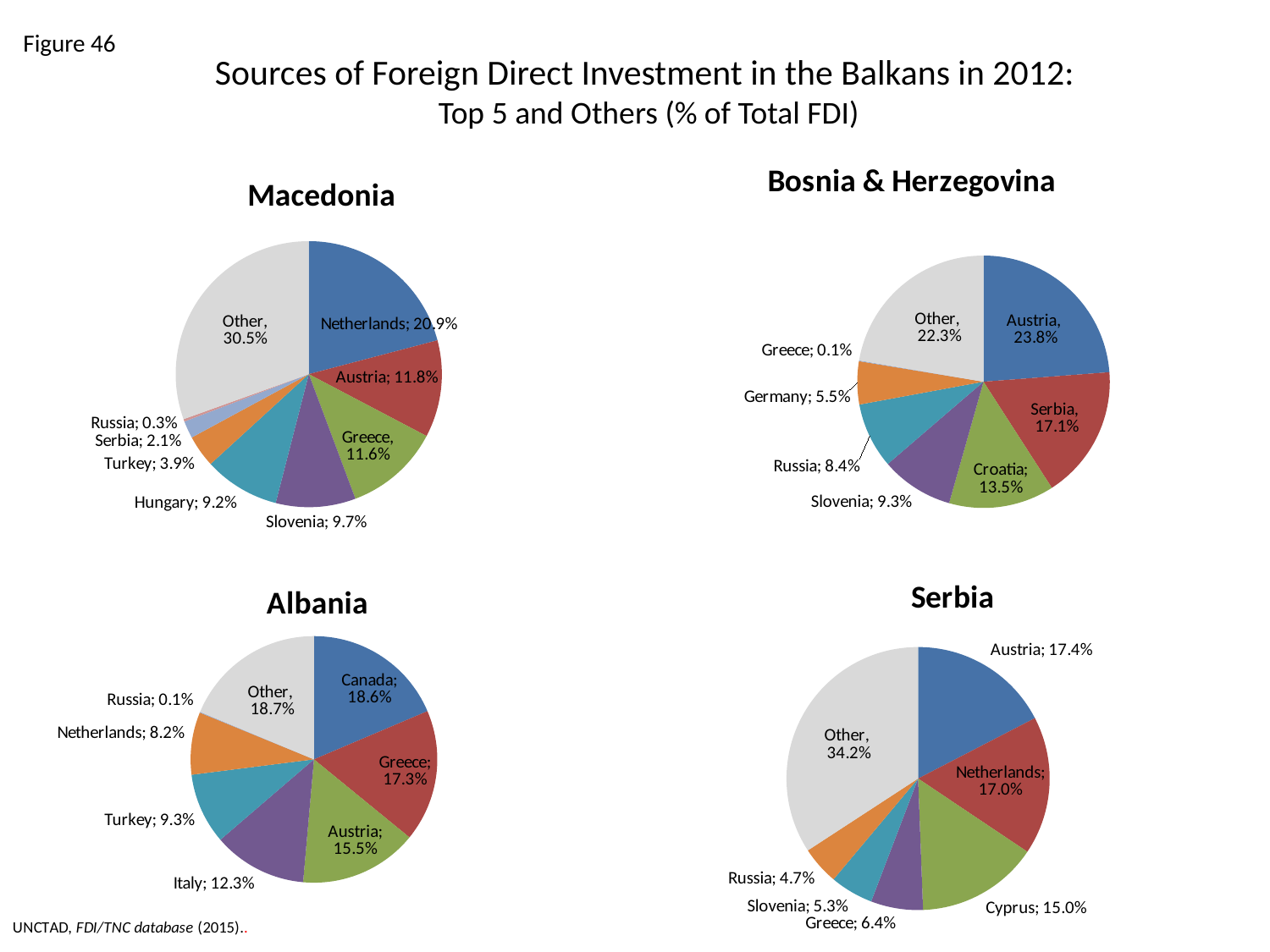
In the Serbia chart, what is the value for Cyprus? 15.0% In the Albania chart, which source has the smallest share? Russia In the Macedonia chart, what is the difference between the Netherlands share and the Austria share? 9.1% In the Macedonia chart, what share of FDI comes from the Netherlands? 20.9% In the Bosnia & Herzegovina chart, which named country (excluding Other) has the largest share? Austria In the Bosnia & Herzegovina chart, what is the combined share of Serbia and Croatia? 30.6% In the Albania chart, what share of FDI comes from Italy? 12.3% In the Bosnia & Herzegovina chart, what is the value for Croatia? 13.5% How many slices does the Serbia pie chart have? 7 In the Serbia chart, which is larger: the share for Greece or the share for Slovenia? Greece How many slices does the Macedonia pie chart have? 9 What type of chart is used for each country on this slide? Pie chart